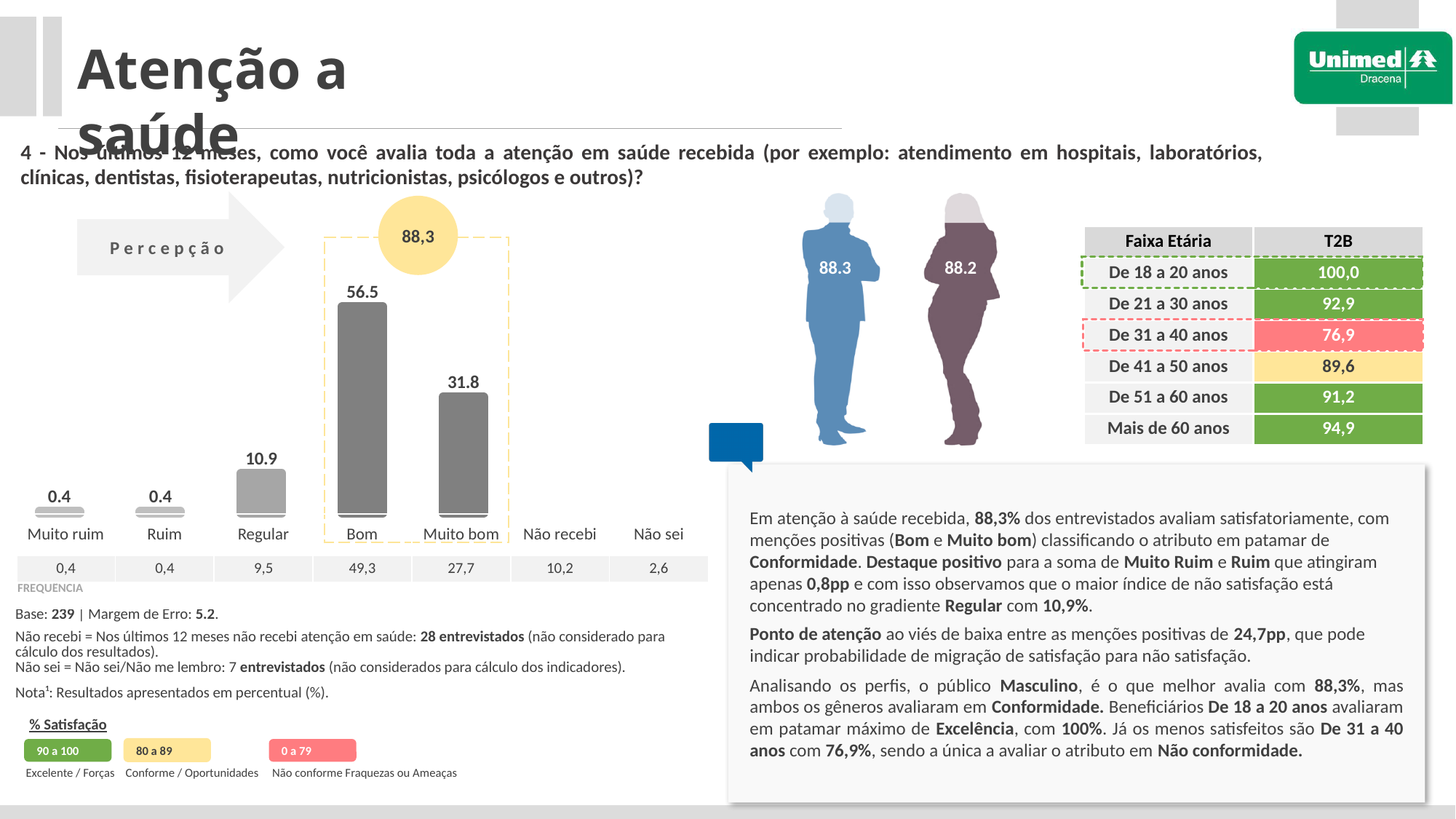
How many categories in the bar chart have a plotted bar with a data label? 5 What is the value for Muito bom in the bar chart? 31.8 What kind of chart is used to show the evaluation categories (Muito ruim to Muito bom)? bar chart What is the combined value of Bom and Muito bom shown in the highlighted circle above the bar chart? 88,3 Which is larger in the bar chart, the value for Regular or the value for Muito bom? Muito bom What is the value for Regular in the bar chart? 10.9 What is the value for Bom in the bar chart? 56.5 What is the difference between the values for Regular and Ruim in the bar chart? 10.5 What is the value for Muito ruim in the bar chart? 0.4 What is the difference between the values for Bom and Muito bom in the bar chart? 24.7 Do the bar values rise or fall from Muito ruim to Bom along the x axis? rise Which category has the highest value in the bar chart? Bom